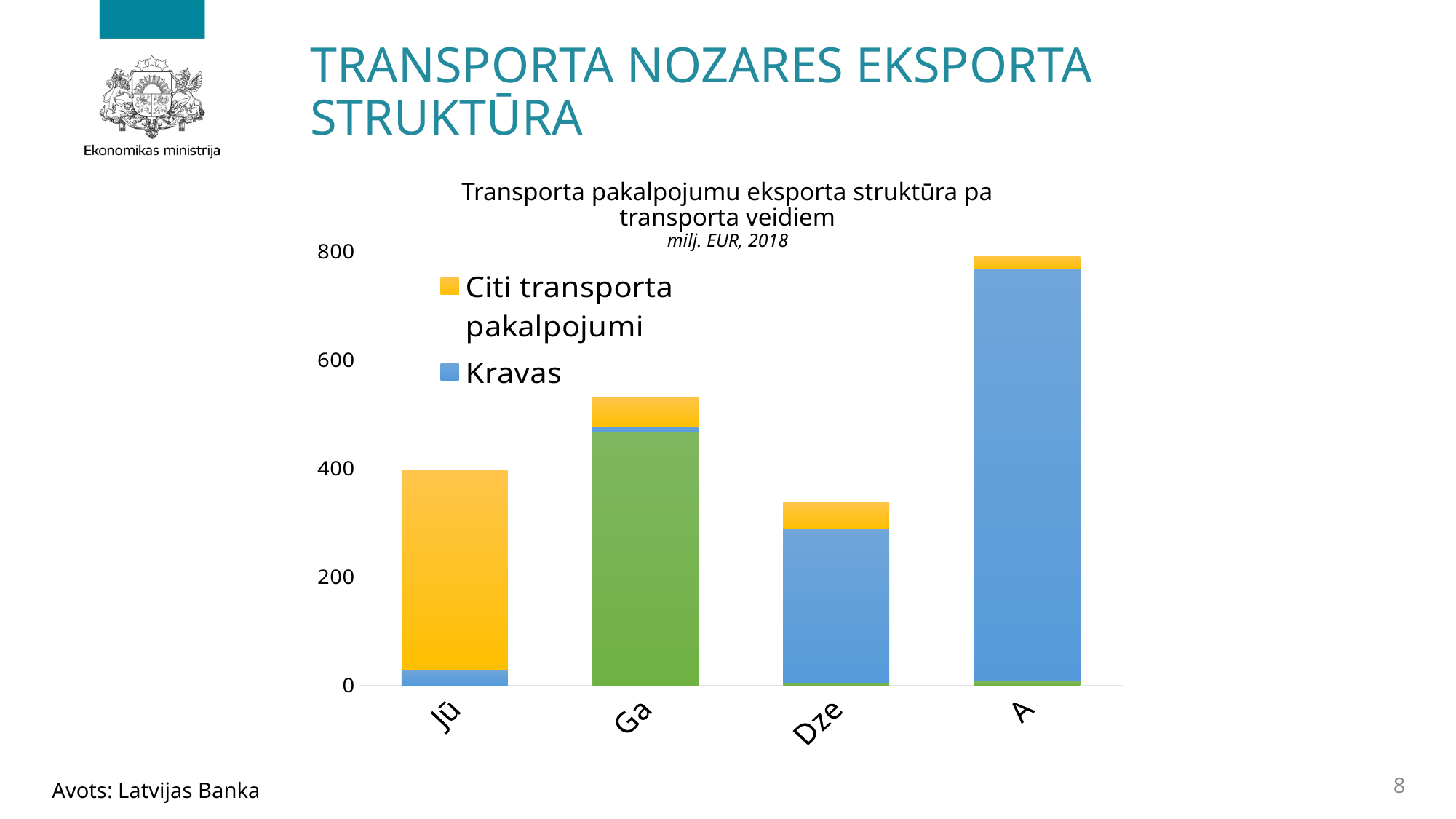
What kind of chart is shown on the slide? bar chart Which category has the tallest stacked bar? A What is the title of the chart? Transporta pakalpojumu eksporta struktūra pa transporta veidiem How many categories are shown on the x axis of the chart? 4 Is the total value for Dze greater or less than 400? less Is the total value for Ga greater or less than 400? greater Which category has the shortest stacked bar? Dze Which stacked bar is taller, Ga or Dze? Ga Which stacked bar is taller, A or Jū? A Is the total value for A greater or less than 600? greater How many series does the chart legend list? 2 Which series is shown in yellow in the chart legend? Citi transporta pakalpojumi